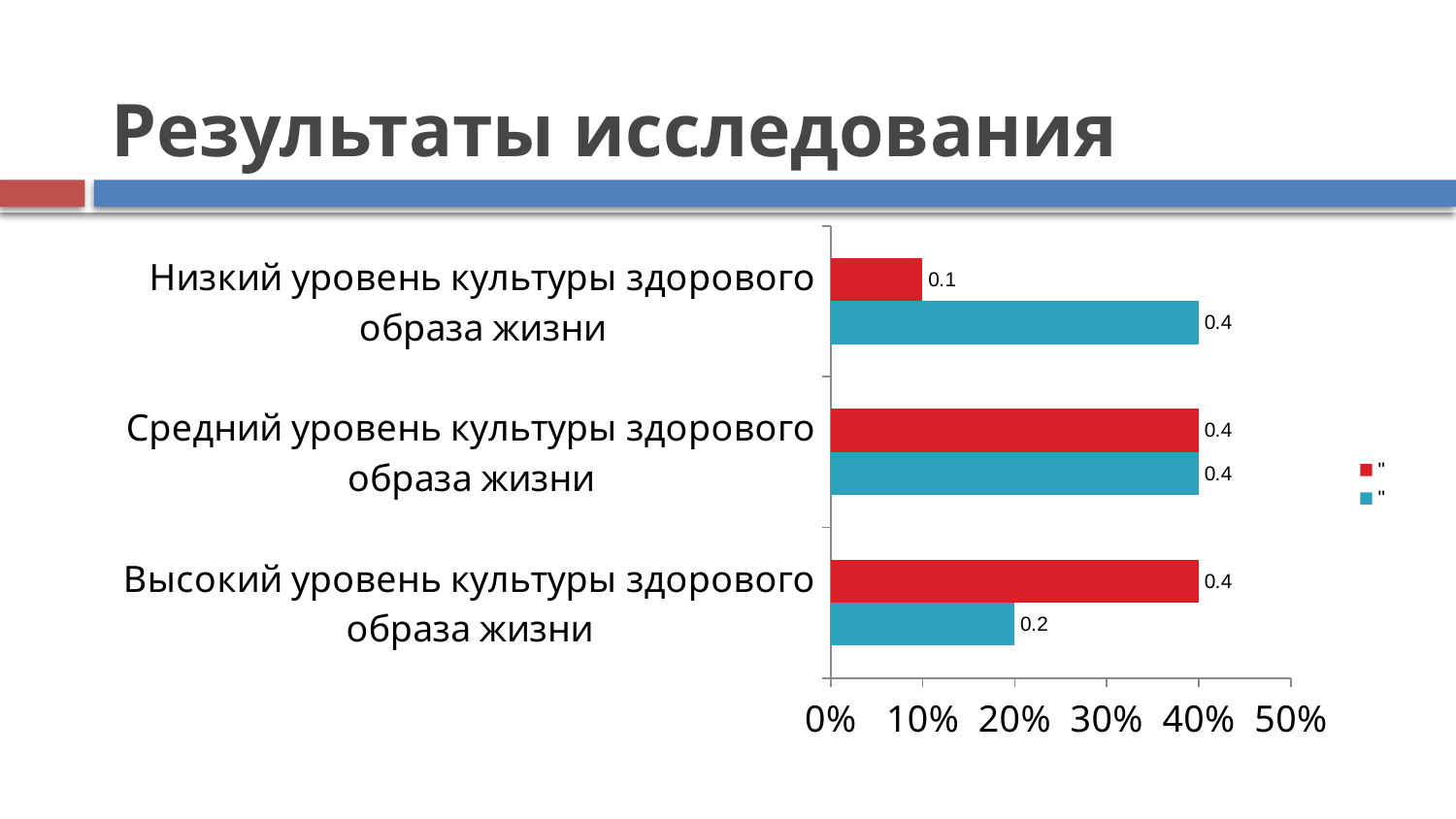
For "Высокий уровень культуры здорового образа жизни", which bar is larger, the red or the blue? red What is the value of the red bar for "Низкий уровень культуры здорового образа жизни"? 0.1 What is the difference between the red and blue bars for "Высокий уровень культуры здорового образа жизни"? 0.2 What is the difference between the blue and red bars for "Низкий уровень культуры здорового образа жизни"? 0.3 What is the value of the blue bar for "Высокий уровень культуры здорового образа жизни"? 0.2 What is the value of the blue bar for "Низкий уровень культуры здорового образа жизни"? 0.4 Which category has the lowest value for the red series? Низкий уровень культуры здорового образа жизни What kind of chart is shown on the slide? bar chart How many series does the legend list? 2 How many categories are shown on the chart? 3 Which category has the lowest value for the blue series? Высокий уровень культуры здорового образа жизни What is the value of the red bar for "Средний уровень культуры здорового образа жизни"? 0.4